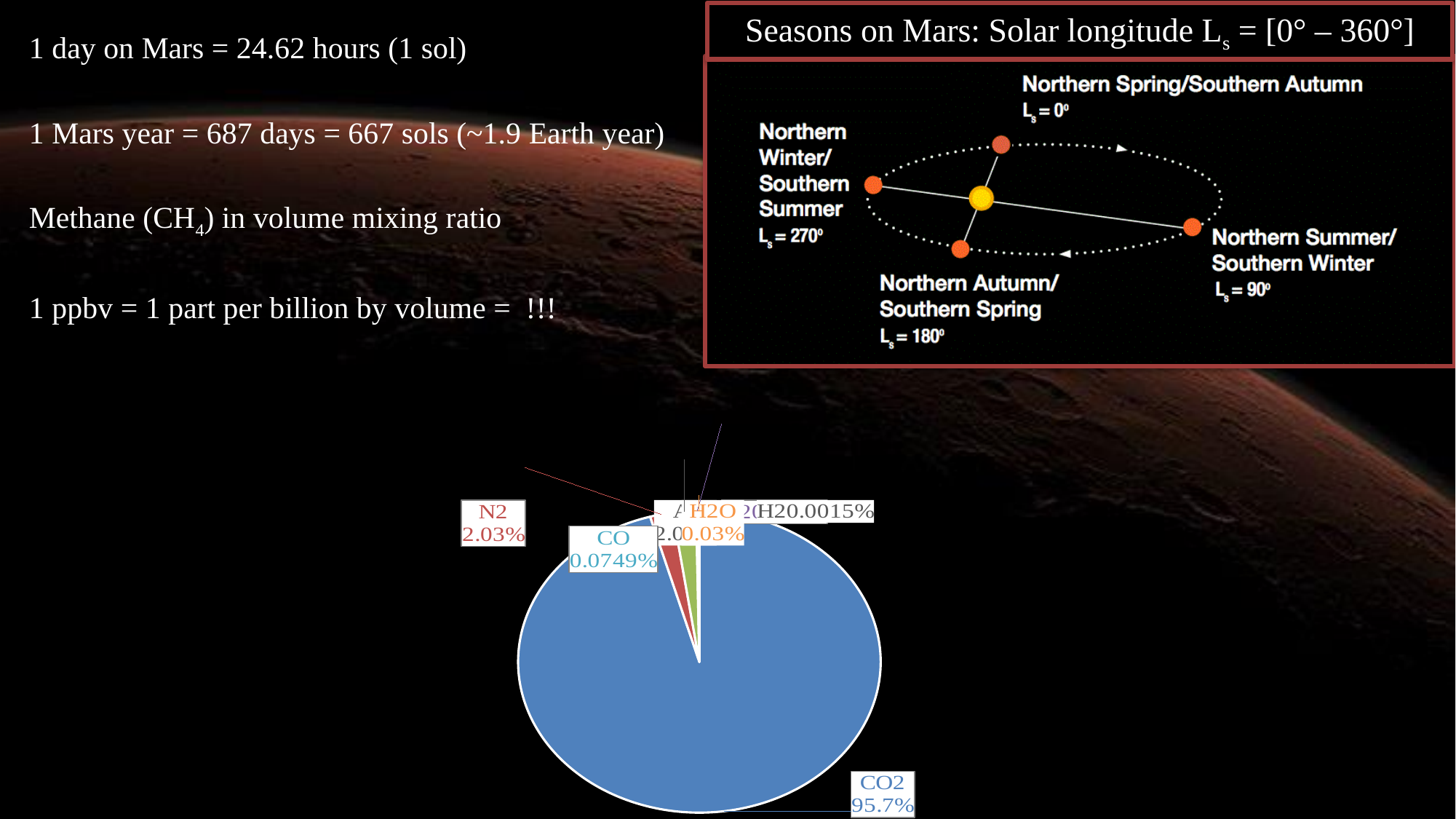
In the pie chart, which is larger, N2 or CO? N2 In the pie chart, what is the value shown for N2? 2.03% In the pie chart, what is the value shown for CO? 0.0749% What colour is the CO2 slice in the pie chart? blue In the pie chart, which is larger, CO or H2O? CO In the pie chart, what is the value shown for H2O? 0.03% In the pie chart, what is the value shown for CO2? 95.7% Which slice of the pie chart is the largest? CO2 What share of the pie chart does CO2 take? 95.7% In the pie chart, what is the difference between the CO2 value and the N2 value? 93.67% What colour is the N2 slice in the pie chart? red What kind of chart is shown at the bottom of the slide? pie chart